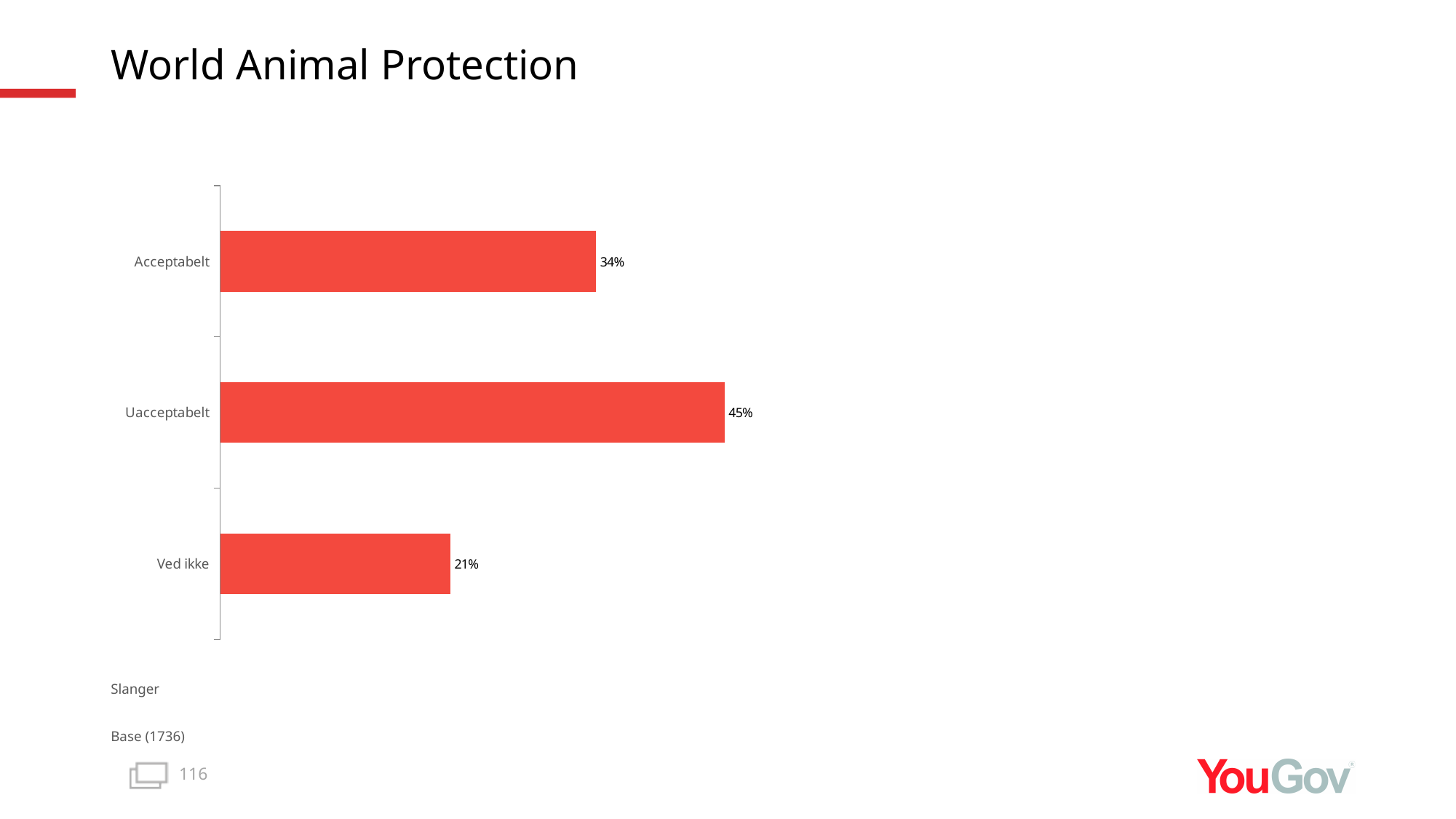
What base size is stated below the chart? 1736 What is the title of the slide? World Animal Protection What is the value for Uacceptabelt? 45% Which category has the lowest value? Ved ikke What is the value for Ved ikke? 21% What is the difference between the values for Acceptabelt and Ved ikke? 13% Which is larger, the value for Acceptabelt or the value for Ved ikke? Acceptabelt How many categories are shown in the chart? 3 What is the difference between the values for Uacceptabelt and Acceptabelt? 11% What kind of chart is shown on the slide? Bar chart Which category has the highest value? Uacceptabelt What is the value for Acceptabelt? 34%